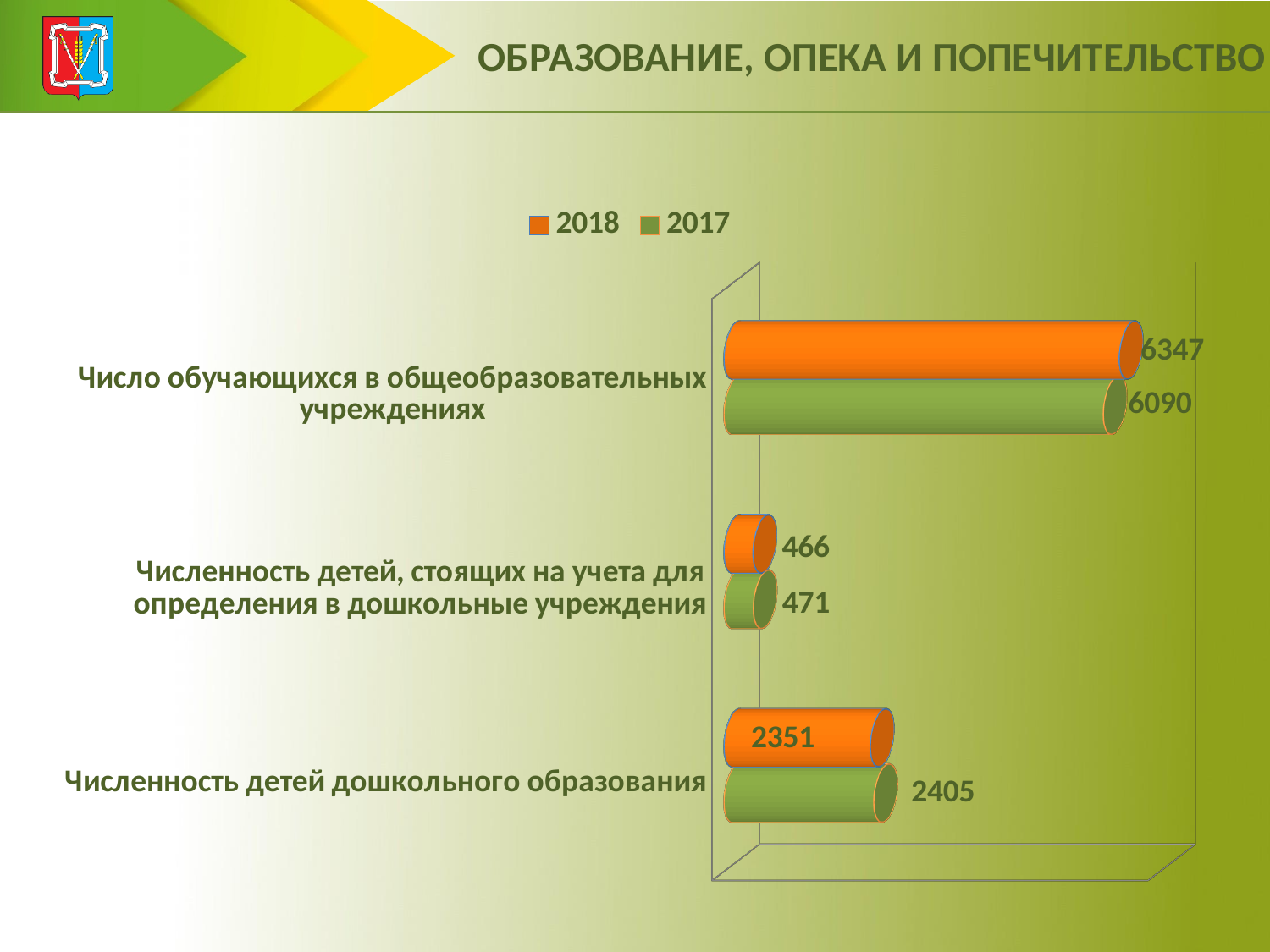
For "Численность детей дошкольного образования", which year has the larger value, 2018 or 2017? 2017 What is the 2017 value for "Численность детей дошкольного образования"? 2405 Which category has the highest 2018 value? Число обучающихся в общеобразовательных учреждениях Which category has the lowest 2017 value? Численность детей, стоящих на учета для определения в дошкольные учреждения What kind of chart is shown on the slide? Bar chart What is the 2018 value for "Численность детей, стоящих на учета для определения в дошкольные учреждения"? 466 What is the 2018 value for "Число обучающихся в общеобразовательных учреждениях"? 6347 What is the 2017 value for "Число обучающихся в общеобразовательных учреждениях"? 6090 How many categories are shown on the chart? 3 How many series does the legend list? 2 What is the difference between the 2018 and 2017 values for "Число обучающихся в общеобразовательных учреждениях"? 257 What is the difference between the 2017 and 2018 values for "Численность детей дошкольного образования"? 54